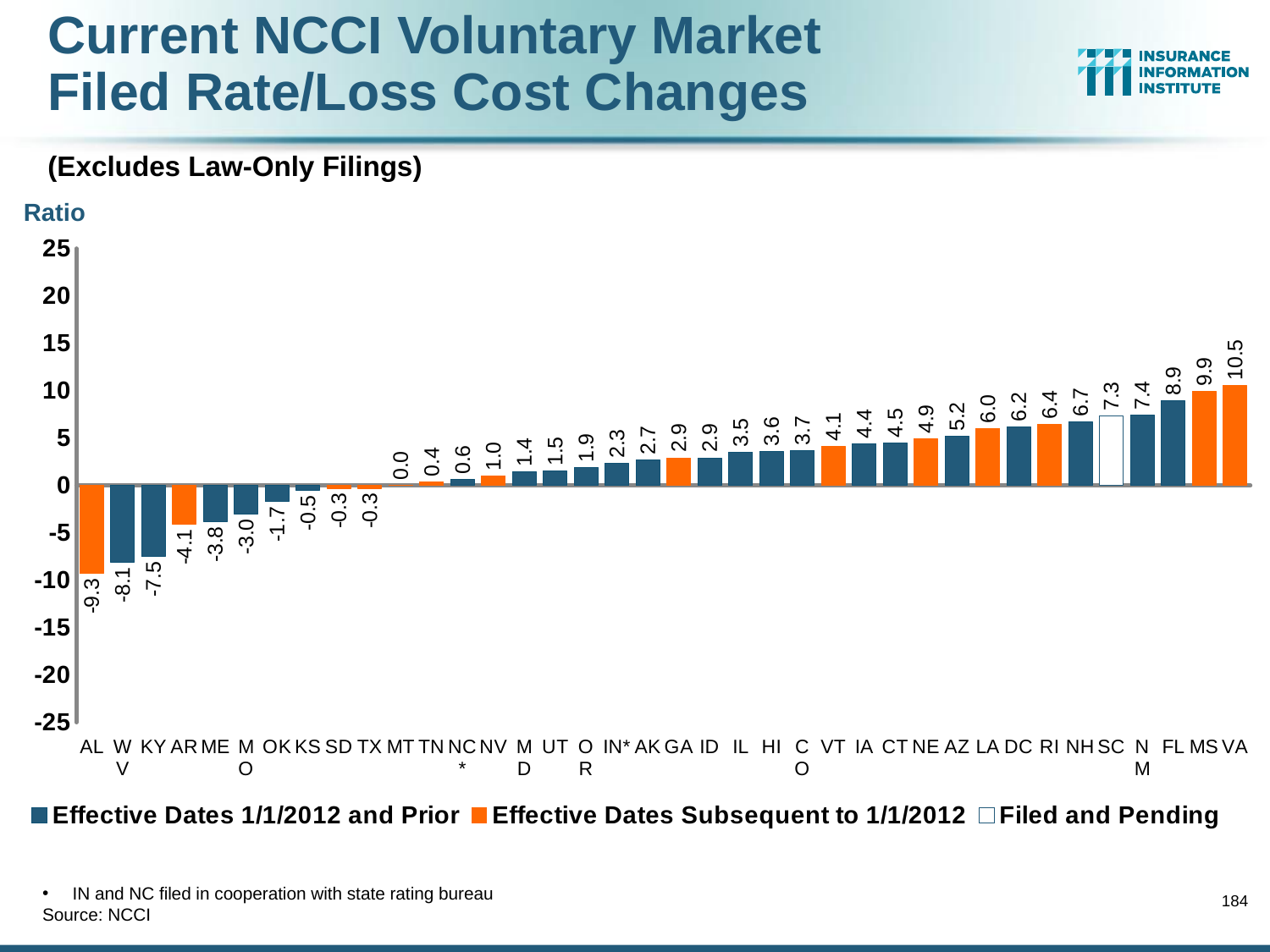
What is the value for AL? -9.3 Is the value for KY greater or less than -5? less How many series does the legend list? 3 What kind of chart is this? bar chart Which has a larger value, FL or NH? FL Which state has the lowest value? AL How many states are shown on the x axis? 38 What is the difference between the values for VA and MS? 0.6 What is the value for VA? 10.5 Which series does the SC bar belong to, according to the legend? Filed and Pending What is the value for SC? 7.3 Which state has the highest value? VA